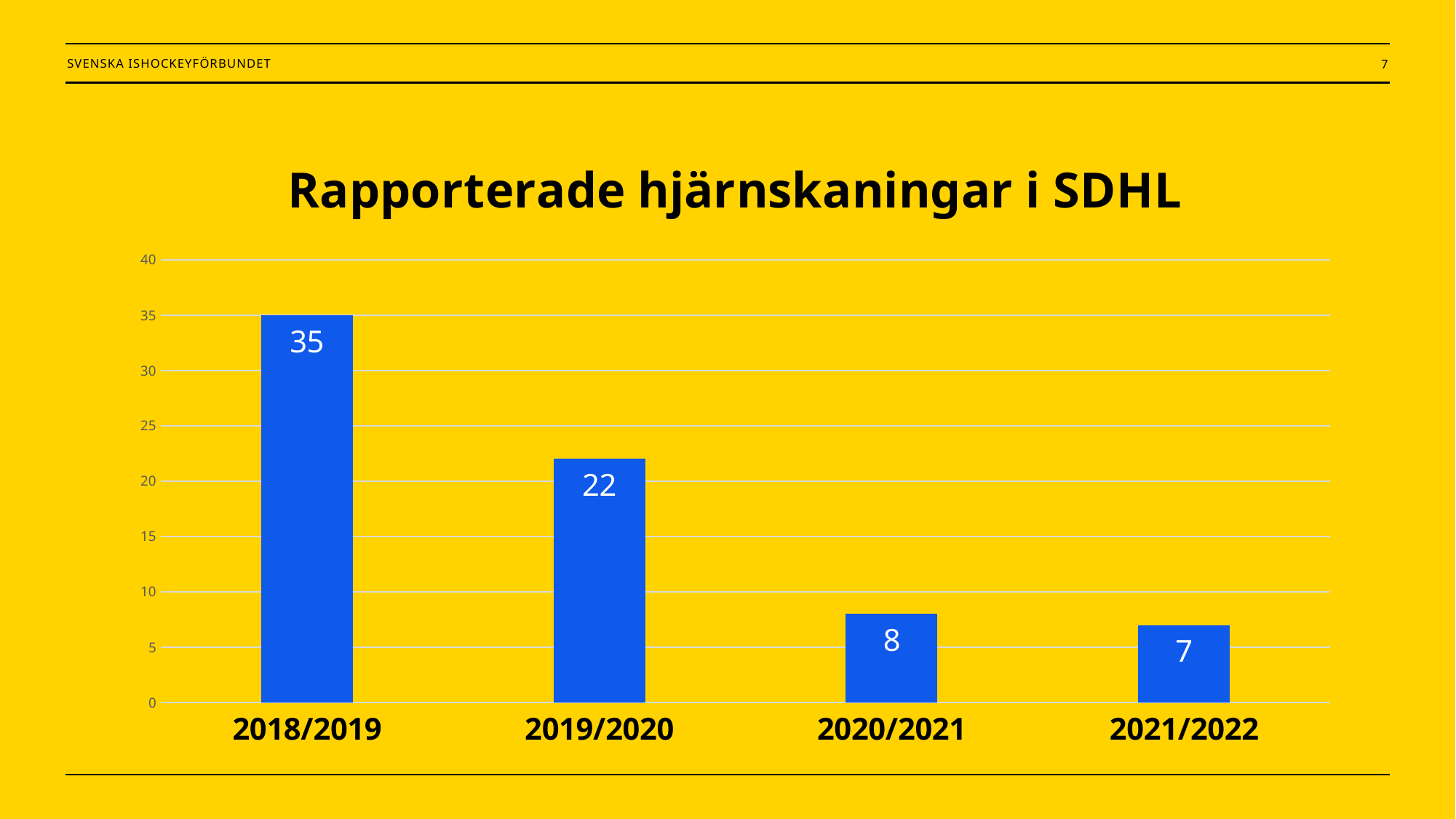
Which season has the lowest value? 2021/2022 What is the value for 2018/2019? 35 What is the value for 2021/2022? 7 What is the value for 2019/2020? 22 How many seasons are shown on the x axis? 4 Do the values rise or fall from 2018/2019 to 2021/2022? fall Which season has the highest value? 2018/2019 What is the value for 2020/2021? 8 Which is larger, the value for 2019/2020 or the value for 2020/2021? 2019/2020 What is the difference between the values for 2018/2019 and 2019/2020? 13 What kind of chart is shown on the slide? bar chart Is the value for 2019/2020 greater or less than 20? greater